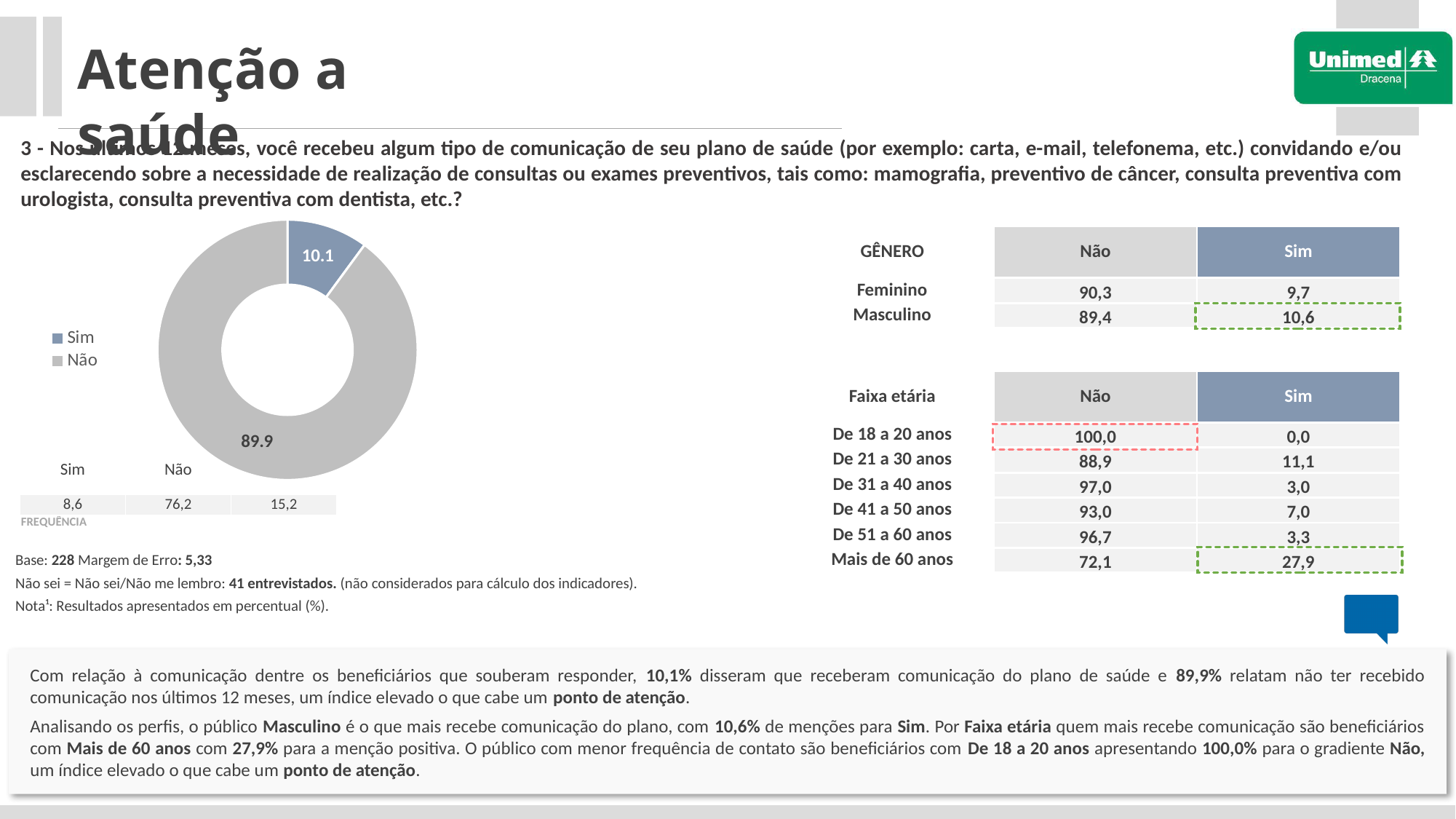
What share of the donut chart does the Sim slice represent? 10.1 How many entries does the legend of the donut chart list? 2 Which category has the largest slice in the donut chart? Não In the donut chart, what is the value shown for Sim? 10.1 What type of chart is shown on the left of the slide? Pie chart (donut) How many categories are plotted in the donut chart? 2 What is the difference between the Não and Sim values in the donut chart? 79.8 In the donut chart, which is larger: Sim or Não? Não What are the two legend entries of the donut chart? Sim and Não In the donut chart, what is the value shown for Não? 89.9 Which category has the smallest slice in the donut chart? Sim What colour is the Sim slice in the donut chart? Blue